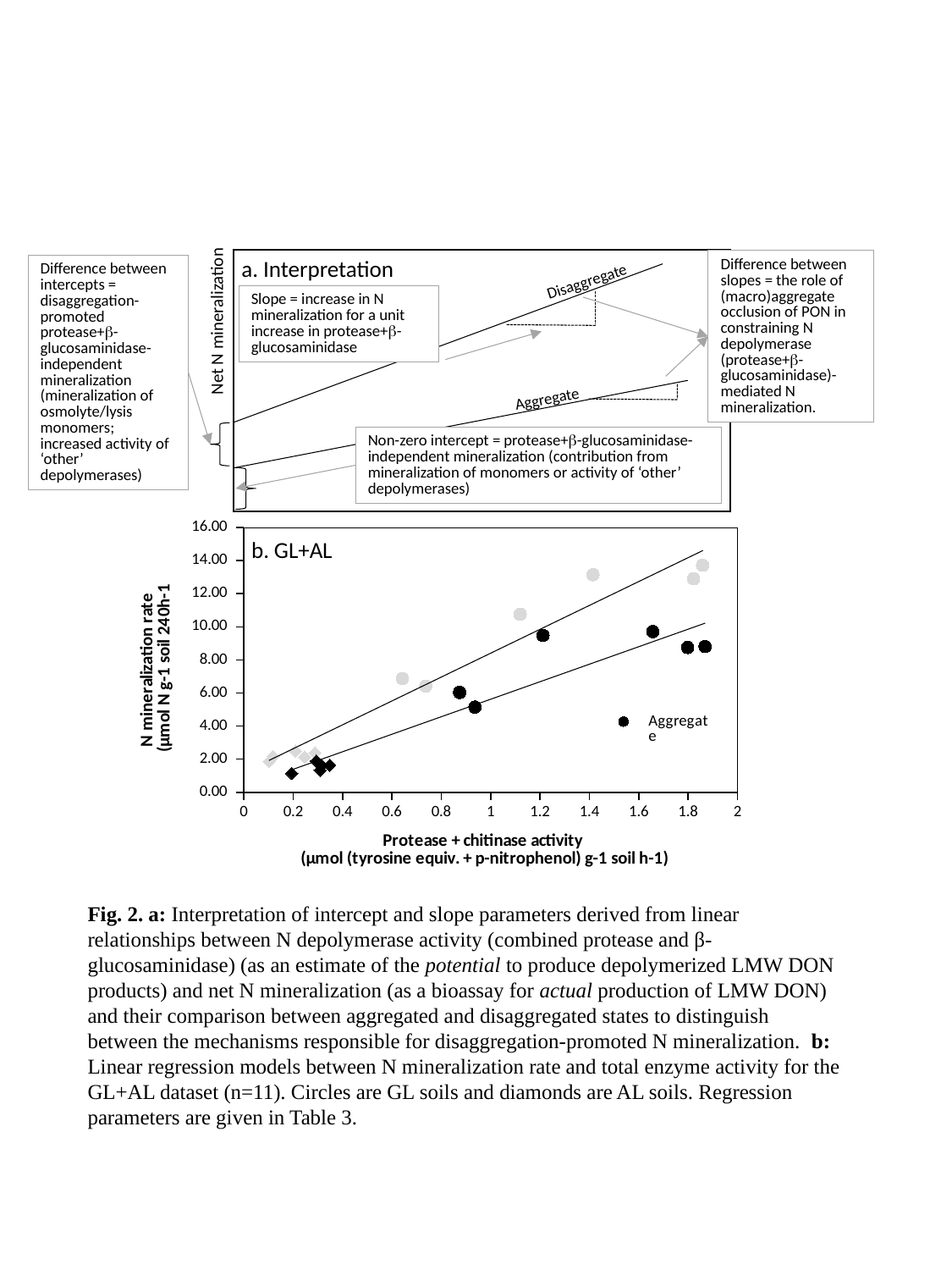
In the 'b. GL+AL' chart, which series reaches higher N mineralization rates, the light grey points or the black points? light grey In the 'a. Interpretation' chart, which line has the higher intercept on the y axis, Disaggregate or Aggregate? Disaggregate In the 'b. GL+AL' chart, do the N mineralization rate values rise or fall as protease + chitinase activity increases? rise In the 'b. GL+AL' chart, are the diamond points near x = 0.2 to 0.4 greater or less than 4.00? less What legend entry is shown in the 'b. GL+AL' chart? Aggregate What is the y-axis label of the 'a. Interpretation' chart? Net N mineralization In the 'a. Interpretation' chart, which of the two lines, Disaggregate or Aggregate, has the steeper slope? Disaggregate In the 'b. GL+AL' chart, are the black circles plotted near x = 1.8 greater or less than 10.00? less What kind of chart is the 'b. GL+AL' chart? scatter chart In the 'b. GL+AL' chart, is the highest light grey point greater or less than 12.00? greater In the 'a. Interpretation' chart, do both lines rise or fall from left to right? rise